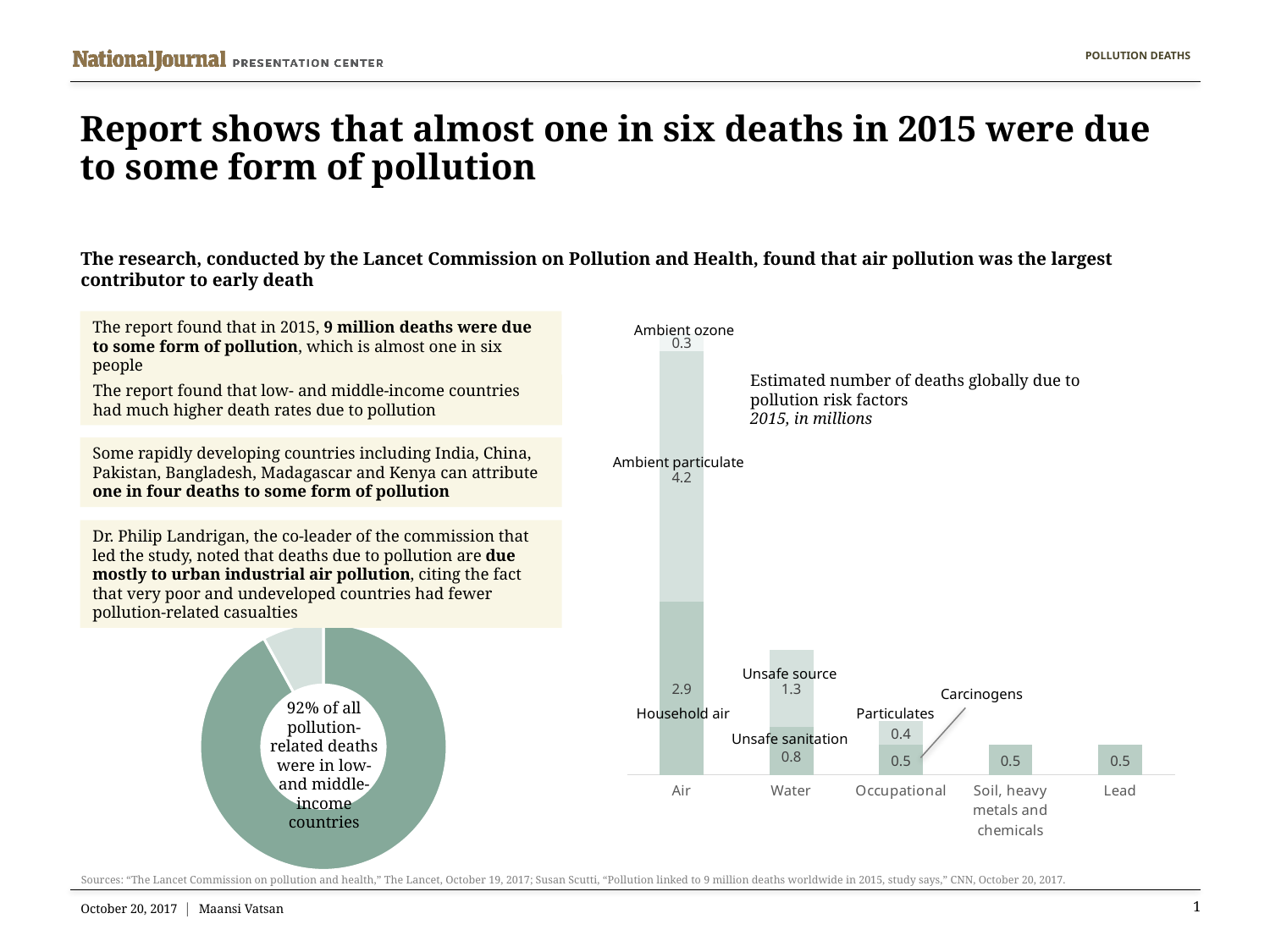
How many categories are shown on the x axis of the bar chart of estimated deaths due to pollution risk factors? 5 In the bar chart of estimated deaths due to pollution risk factors, what is the value for household air? 2.9 In the bar chart of estimated deaths due to pollution risk factors, what is the difference between ambient particulate and household air? 1.3 In the bar chart of estimated deaths due to pollution risk factors, what is the value for unsafe source under Water? 1.3 In the bar chart of estimated deaths due to pollution risk factors, which is larger: unsafe source or unsafe sanitation? Unsafe source In the bar chart of estimated deaths due to pollution risk factors, which category has the highest total? Air In the bar chart of estimated deaths due to pollution risk factors, what is the total for the Water bar? 2.1 In the bar chart of estimated deaths due to pollution risk factors, what is the value for Lead? 0.5 In the donut chart on the left, what share of all pollution-related deaths were in low- and middle-income countries? 92% In the bar chart of estimated deaths due to pollution risk factors, what is the total for the Occupational bar? 0.9 In the bar chart of estimated deaths due to pollution risk factors, what is the total for the Air bar? 7.4 In the bar chart of estimated deaths due to pollution risk factors, what is the value for ambient particulate? 4.2